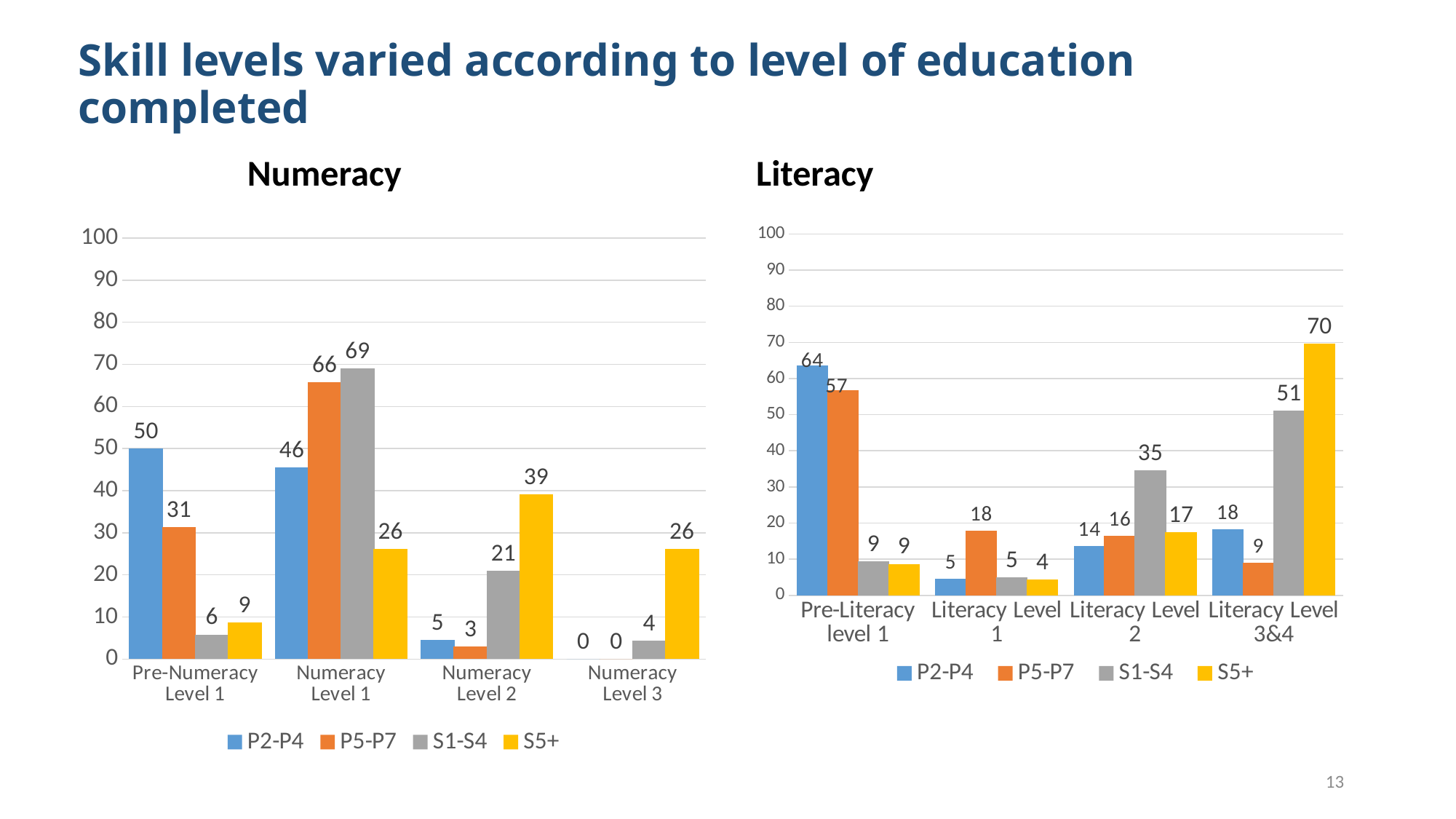
What kind of chart is the Literacy chart? Bar chart In the Literacy chart, what is the difference between the P2-P4 value and the P5-P7 value at Pre-Literacy level 1? 7 In the Numeracy chart, what is the value for P5-P7 at Numeracy Level 3? 0 In the Numeracy chart, what is the value for S1-S4 at Numeracy Level 1? 69 How many categories are shown on the x axis of the Numeracy chart? 4 In the Literacy chart, which series has the highest value at Pre-Literacy level 1? P2-P4 In the Numeracy chart, which series has the lowest value at Numeracy Level 2? P5-P7 How many series does the legend of the Literacy chart list? 4 In the Numeracy chart, what is the value for P2-P4 at Pre-Numeracy Level 1? 50 In the Literacy chart, which is larger at Literacy Level 2: the S1-S4 value or the S5+ value? S1-S4 In the Literacy chart, what is the value for S5+ at Literacy Level 3&4? 70 In the Numeracy chart, what is the difference between the S5+ value and the S1-S4 value at Numeracy Level 2? 18